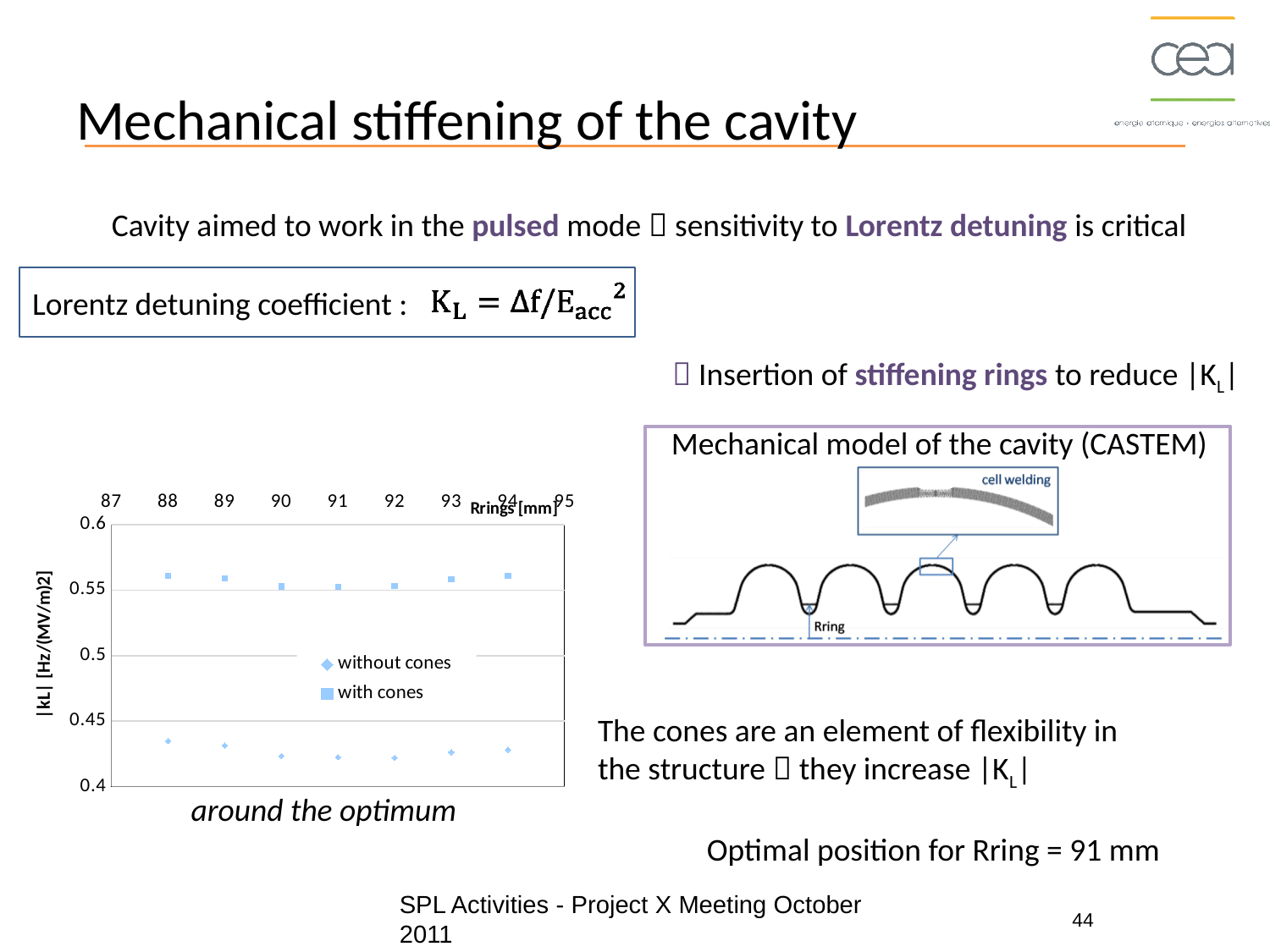
What is the label of the chart's x axis? Rrings [mm] What kind of chart is shown on the slide? scatter chart Is the 'with cones' value at Rring = 91 mm greater or less than 0.5? greater Do the 'without cones' values rise or fall as Rring goes from 92 mm to 94 mm? rise How many series does the chart legend list? 2 At Rring = 94 mm, which series has the larger value, 'with cones' or 'without cones'? with cones Do the 'with cones' values rise or fall as Rring goes from 88 mm to 91 mm? fall Is the 'with cones' value at Rring = 88 mm greater or less than 0.55? greater Is the 'without cones' value at Rring = 91 mm greater or less than 0.45? less How many data points are plotted for the 'with cones' series? 7 What are the two series named in the chart legend? without cones, with cones Which series has the higher |kL| values across all Rring positions, 'with cones' or 'without cones'? with cones